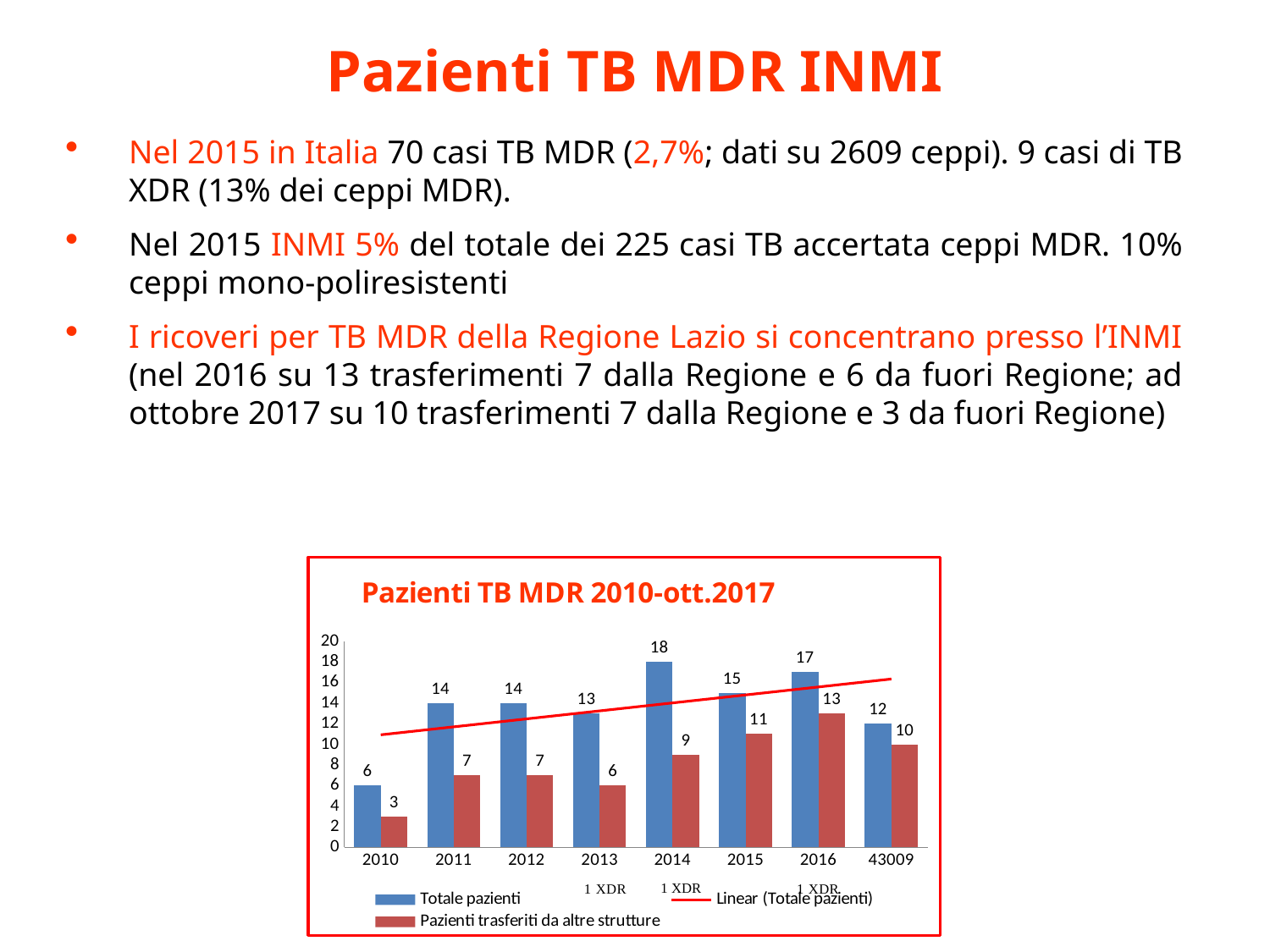
What is the title of the chart? Pazienti TB MDR 2010-ott.2017 What is the value of Totale pazienti for 2014? 18 Which year has the highest value for Pazienti trasferiti da altre strutture? 2016 What kind of chart is shown on the slide? Bar chart What is the difference between Totale pazienti and Pazienti trasferiti da altre strutture in 2013? 7 What is the value of Pazienti trasferiti da altre strutture for 2016? 13 Which year has the lowest value for Totale pazienti? 2010 How many categories are shown on the x axis of the chart? 8 How many entries does the chart legend list? 3 What is the value of Pazienti trasferiti da altre strutture for 2010? 3 Which is larger: Totale pazienti in 2015 or Totale pazienti in 2016? Totale pazienti in 2016 Which year has the highest value for Totale pazienti? 2014